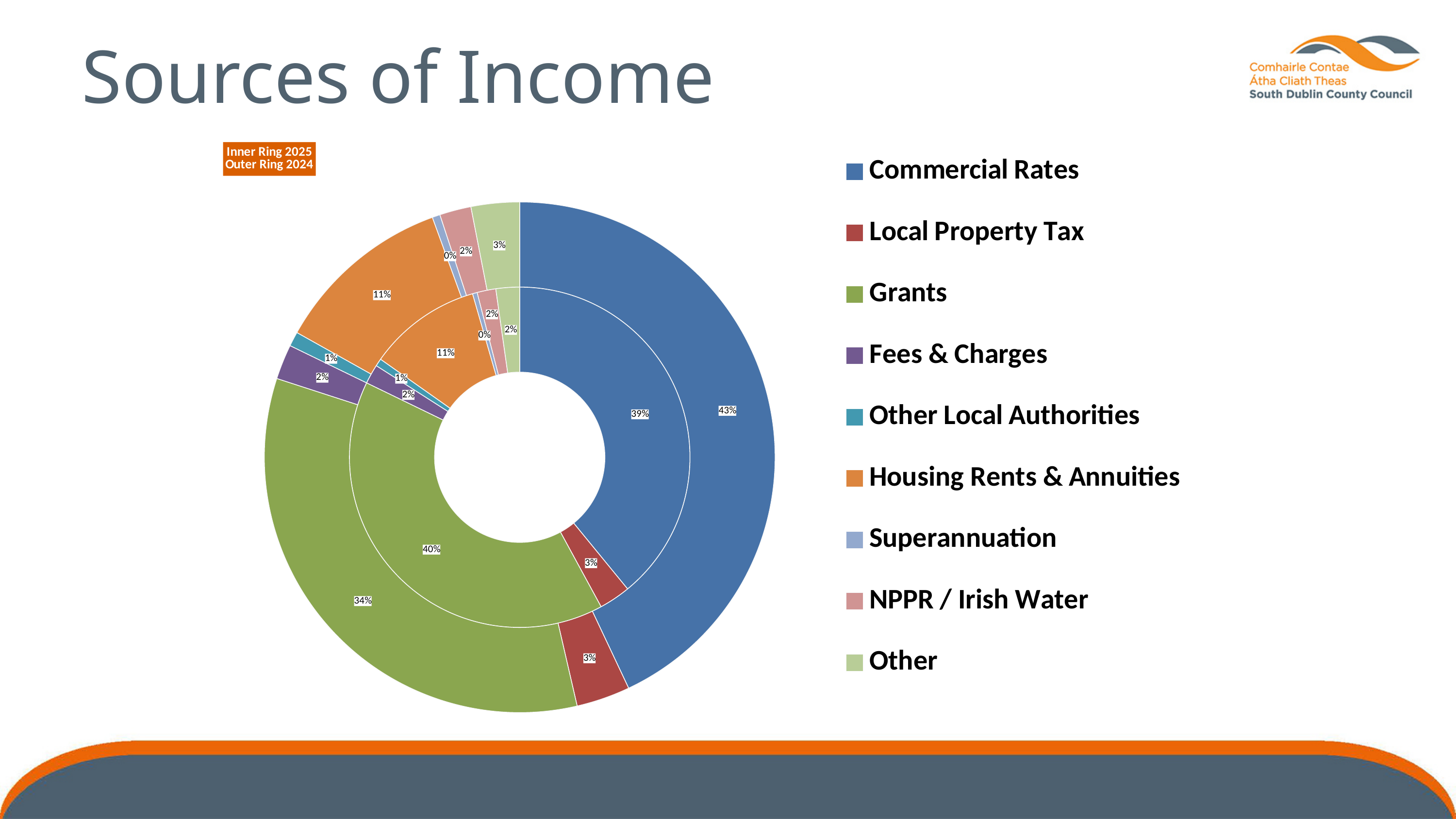
What kind of chart is shown on the slide? Doughnut chart How many categories does the legend list? 9 Which is larger in the outer ring (2024): the share for Grants or the share for Housing Rents & Annuities? Grants What share of income do Grants have in the outer ring (2024)? 34% What share of income do Grants have in the inner ring (2025)? 40% By how many percentage points did the Commercial Rates share fall from the outer ring (2024) to the inner ring (2025)? 4 percentage points Which year does the inner ring of the chart represent? 2025 Which category has the largest share in the inner ring (2025)? Grants Which category has the largest share in the outer ring (2024)? Commercial Rates What share of income does Commercial Rates have in the outer ring (2024)? 43% What share of income do Housing Rents & Annuities have in the outer ring (2024)? 11% What share of income does Commercial Rates have in the inner ring (2025)? 39%